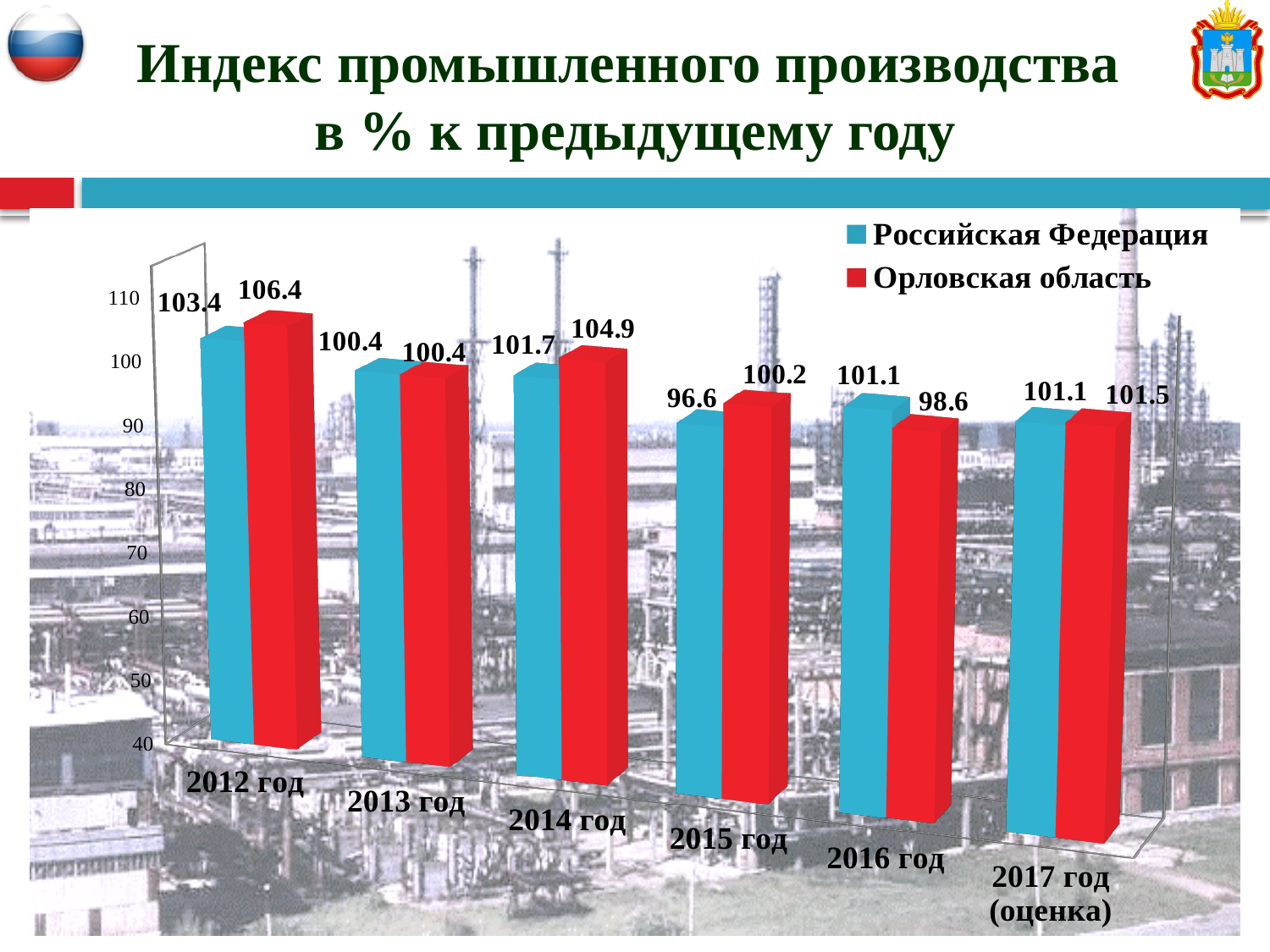
What is the value for Орловская область in 2016 год? 98.6 How many series does the legend list? 2 In 2016 год, which series has the larger value, Российская Федерация or Орловская область? Российская Федерация What kind of chart is shown on the slide? bar chart Which colour represents Орловская область in the chart? red How many years are shown on the x axis? 6 What is the value for Российская Федерация in 2017 год (оценка)? 101.1 What is the difference between the Орловская область and Российская Федерация values in 2014 год? 3.2 What is the value for Орловская область in 2012 год? 106.4 In which year is the value for Российская Федерация the lowest? 2015 год What is the value for Российская Федерация in 2015 год? 96.6 In which year is the value for Орловская область the highest? 2012 год